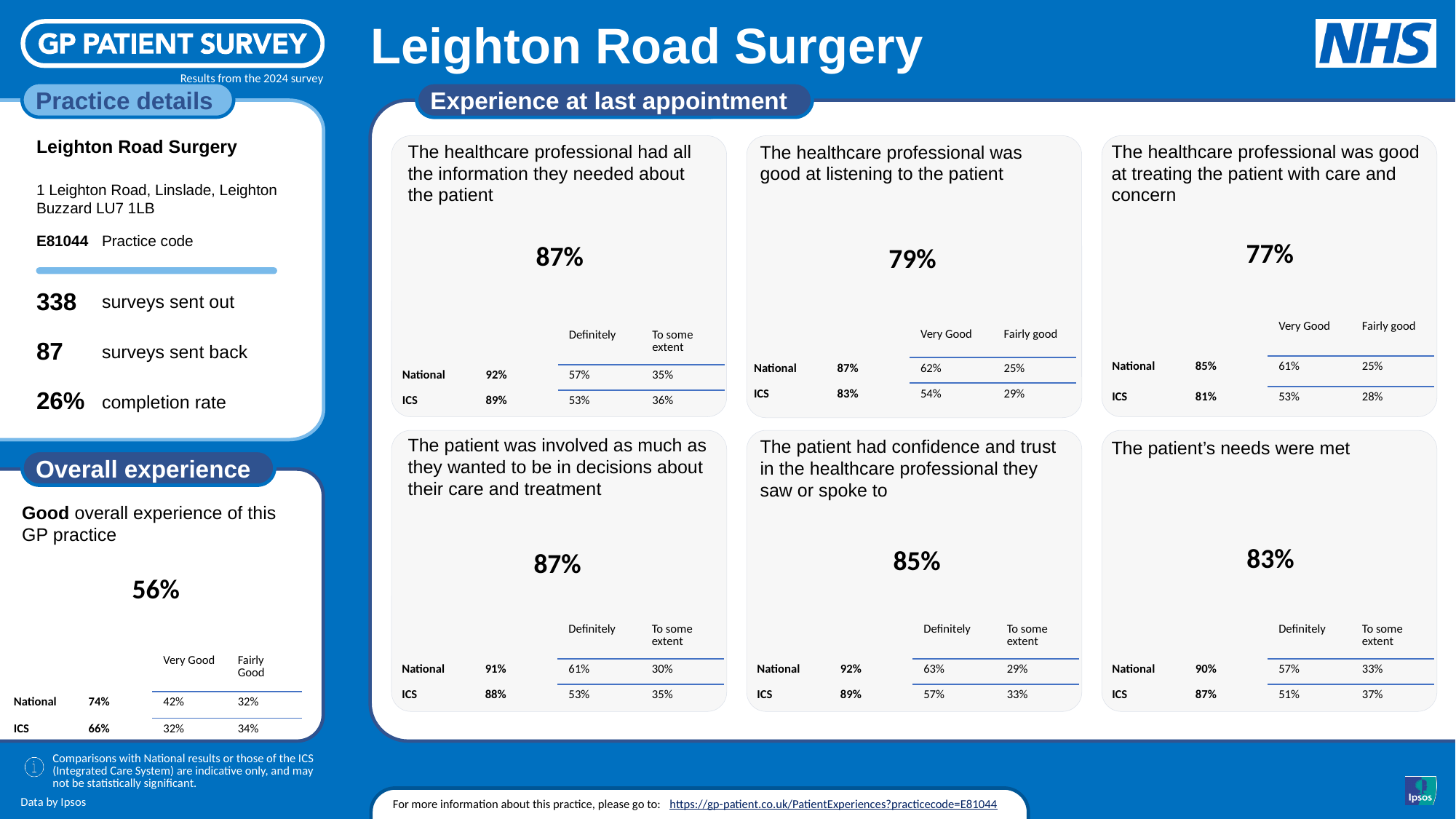
In the panel 'The patient was involved as much as they wanted to be in decisions about their care and treatment', what is the difference between the National figure (91%) and the practice figure (87%)? 4 percentage points How many statement panels are shown under the 'Experience at last appointment' heading? 6 In the panel 'The healthcare professional was good at treating the patient with care and concern', what is the ICS figure? 81% In the panel 'The healthcare professional had all the information they needed about the patient', what is the ICS 'To some extent' percentage? 36% Among the six 'Experience at last appointment' panels, which statement has the lowest practice headline percentage? The healthcare professional was good at treating the patient with care and concern In the 'Overall experience' panel, what percentage of patients reported a good overall experience of this GP practice? 56% In the panel 'The patient's needs were met', what is the National 'Definitely' percentage? 57% In the 'Overall experience' panel, what is the difference between the National figure (74%) and the practice figure (56%)? 18 percentage points In the 'Overall experience' panel, what is the ICS 'Very Good' percentage? 32% In the panel 'The patient had confidence and trust in the healthcare professional they saw or spoke to', which is larger: the National figure or the ICS figure? National In the 'Overall experience' panel, what is the National figure for good overall experience? 74% In the panel 'The healthcare professional was good at listening to the patient', what is the practice's headline percentage? 79%